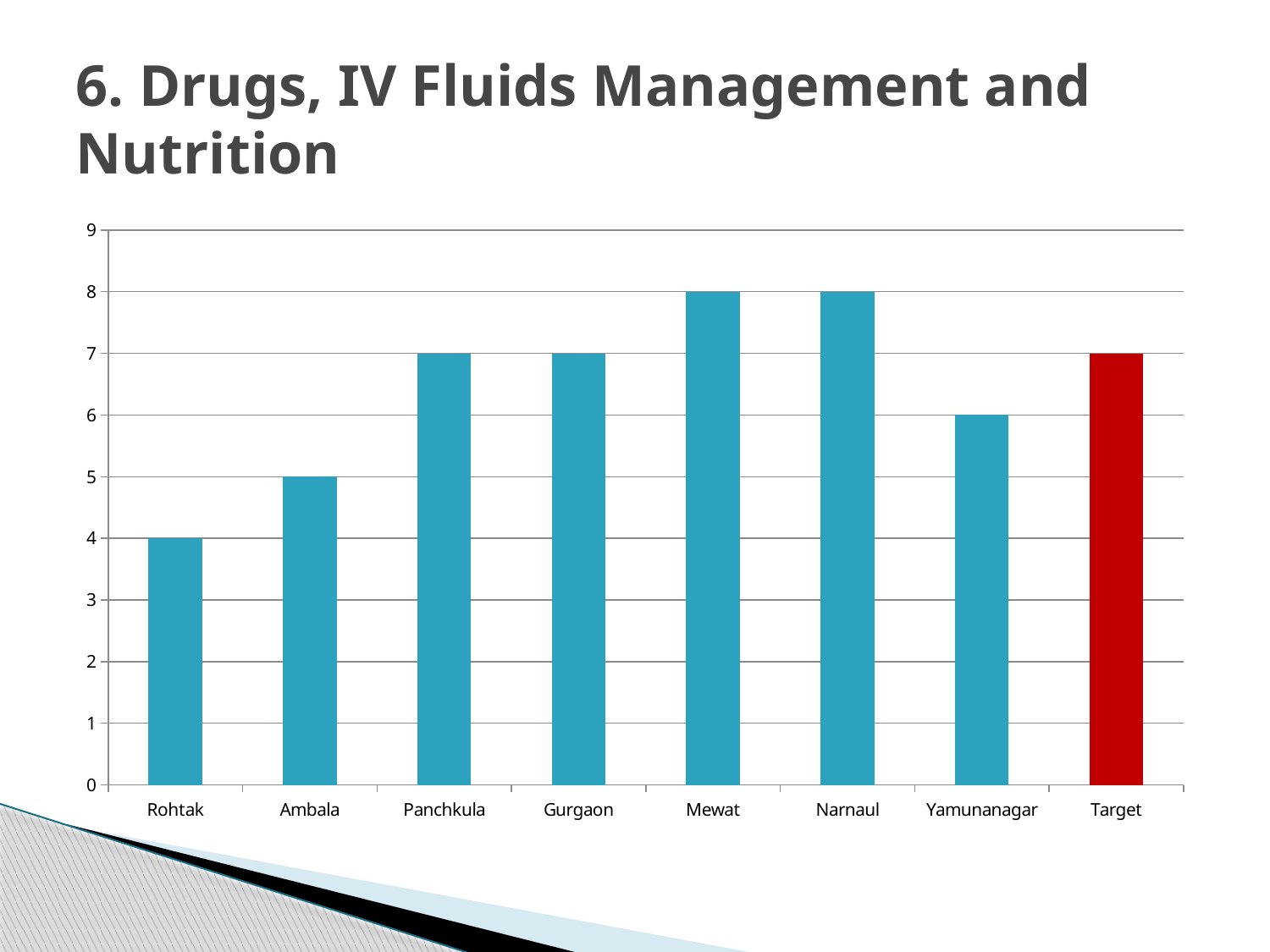
What colour is the Target bar? red What is the value of the Target bar? 7 What is the value for Mewat? 8 How many categories are shown on the x axis? 8 Which category has the lowest value? Rohtak What kind of chart is shown on the slide? bar chart Which is larger, the value for Ambala or the value for Yamunanagar? Yamunanagar What is the difference between the values for Narnaul and Rohtak? 4 What is the value for Yamunanagar? 6 Is the value for Gurgaon greater or less than 5? greater What is the value for Ambala? 5 What is the value for Rohtak? 4